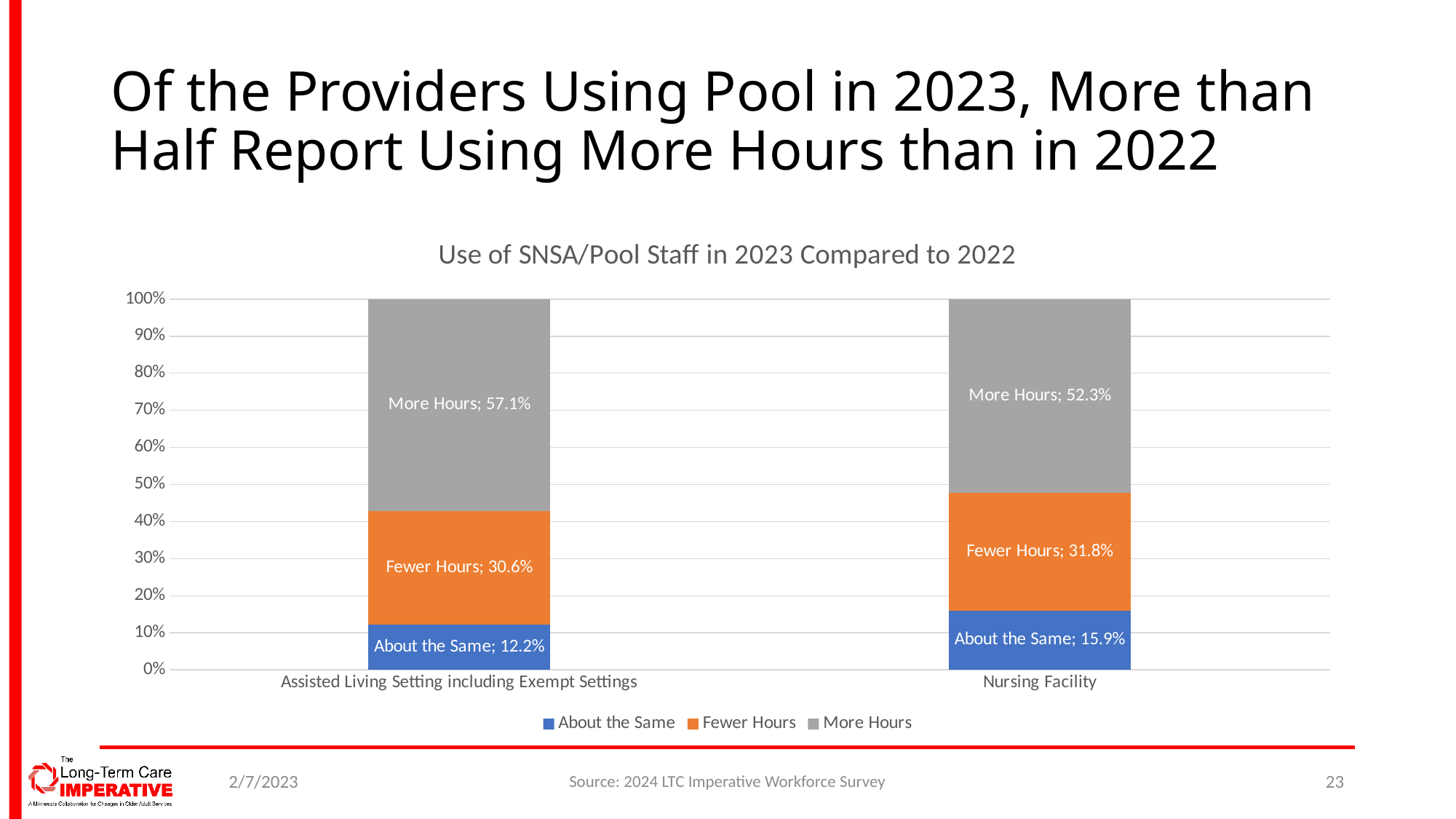
Which segment is the smallest in the Assisted Living Setting including Exempt Settings bar? About the Same Which category has the higher About the Same value? Nursing Facility What is the value for More Hours in the Assisted Living Setting including Exempt Settings bar? 57.1% Which category has the higher More Hours value? Assisted Living Setting including Exempt Settings What is the difference between the More Hours values for Assisted Living Setting including Exempt Settings and Nursing Facility? 4.8% What is the value for More Hours in the Nursing Facility bar? 52.3% Which segment is the largest in the Nursing Facility bar? More Hours What is the value for About the Same in the Assisted Living Setting including Exempt Settings bar? 12.2% What is the difference between the About the Same values for Nursing Facility and Assisted Living Setting including Exempt Settings? 3.7% How many series does the legend list? 3 What is the value for Fewer Hours in the Nursing Facility bar? 31.8% What is the title of the chart? Use of SNSA/Pool Staff in 2023 Compared to 2022